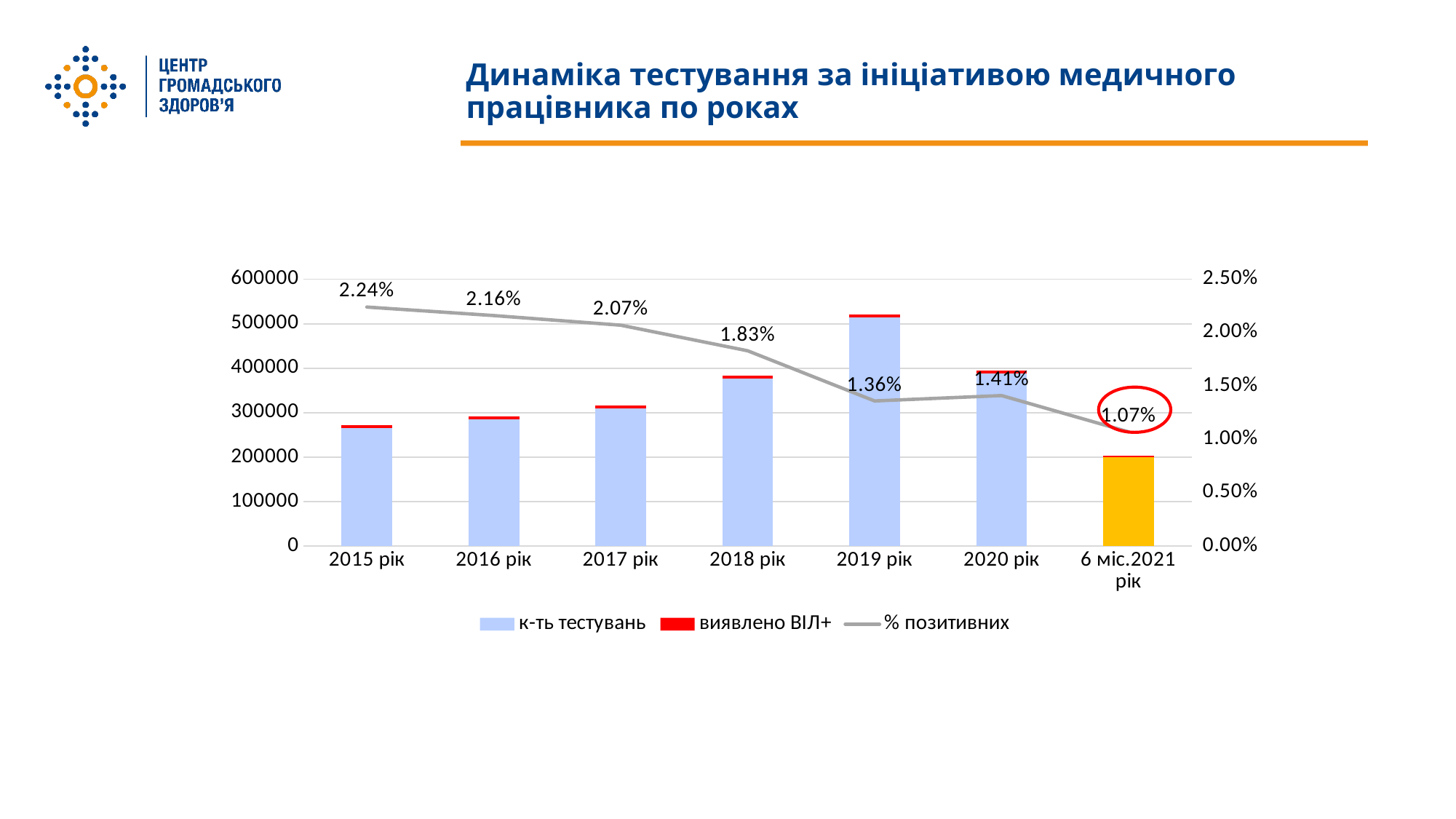
Which year has the tallest bar for к-ть тестувань? 2019 рік What is the value of % позитивних for 2015 рік? 2.24% How many series does the legend list? 3 Which year has the highest % позитивних? 2015 рік What is the difference between the % позитивних for 2015 рік and 6 міс.2021 рік? 1.17% What is the value of % позитивних for 2018 рік? 1.83% Which is larger, the % позитивних for 2019 рік or for 2020 рік? 2020 рік Is the к-ть тестувань bar for 2019 рік greater or less than 500000? greater Is the к-ть тестувань bar for 2015 рік greater or less than 300000? less How many categories are shown on the x axis? 7 What is the value of % позитивних for 6 міс.2021 рік? 1.07% Which category has the lowest % позитивних? 6 міс.2021 рік